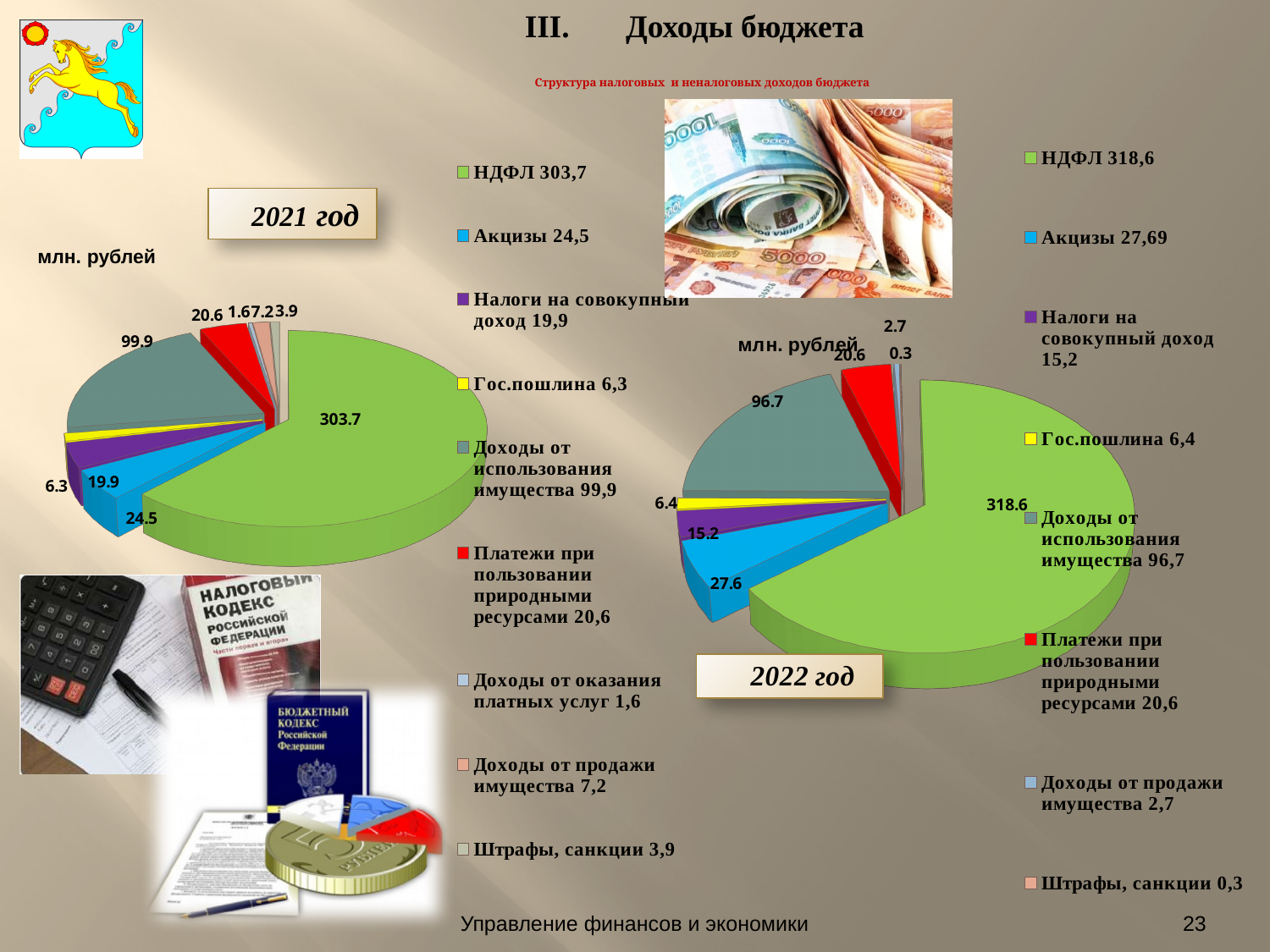
On the 2021 год pie chart, what is the difference between Доходы от использования имущества and Акцизы? 75,4 How much larger is НДФЛ on the 2022 год chart than on the 2021 год chart? 14,9 On the 2021 год pie chart, which category has the smallest value? Доходы от оказания платных услуг How many categories does the 2022 год pie chart show? 8 What type of chart is used for the 2022 год data? Pie chart Which is larger: Доходы от использования имущества on the 2021 год chart or on the 2022 год chart? 2021 год On the 2022 год pie chart, which category has the smallest value? Штрафы, санкции How many categories does the 2021 год pie chart show? 9 On the 2021 год pie chart, what is the value for НДФЛ? 303,7 On the 2022 год pie chart, what is the value for Гос.пошлина? 6,4 On the 2022 год pie chart, what is the value for Штрафы, санкции? 0,3 On the 2021 год pie chart, which category has the largest value? НДФЛ